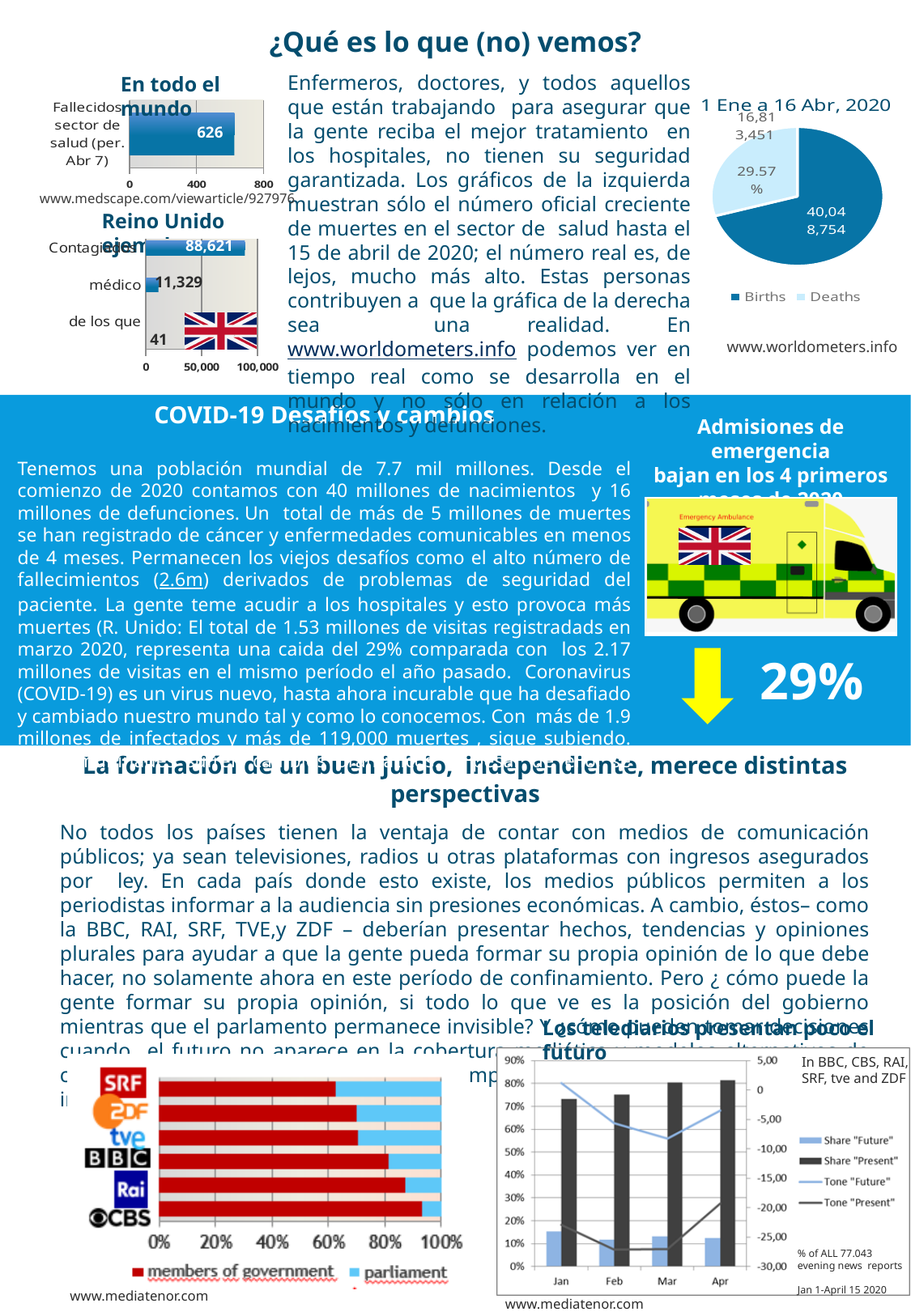
In the bottom-left chart of broadcasters, is the 'members of government' share for CBS greater or less than 80%? greater In the 'En todo el mundo' chart, what is the value for 'Fallecidos sector de salud (per. Abr 7)'? 626 In the 'Reino Unido ejemplo' chart, what is the difference between the 'Contagiados' value and the 'médico' value? 77,292 In the 'Reino Unido ejemplo' chart, what is the value for 'Contagiados'? 88,621 In the 'Reino Unido ejemplo' chart, what is the value for 'médico'? 11,329 In the bottom-left chart of broadcasters, which broadcaster has the smallest share for 'members of government'? SRF What kind of chart is the '1 Ene a 16 Abr, 2020' chart? Pie chart In the 'Los telediarios presentan poco el futuro' chart, how many series does the legend list? 4 In the pie chart titled '1 Ene a 16 Abr, 2020', which slice is larger, Births or Deaths? Births In the bottom-left chart of broadcasters (SRF, ZDF, tve, BBC, Rai, CBS), how many broadcasters are shown? 6 In the pie chart titled '1 Ene a 16 Abr, 2020', what share of the pie do Deaths represent? 29.57% In the 'Reino Unido ejemplo' chart, how many bars are plotted? 3